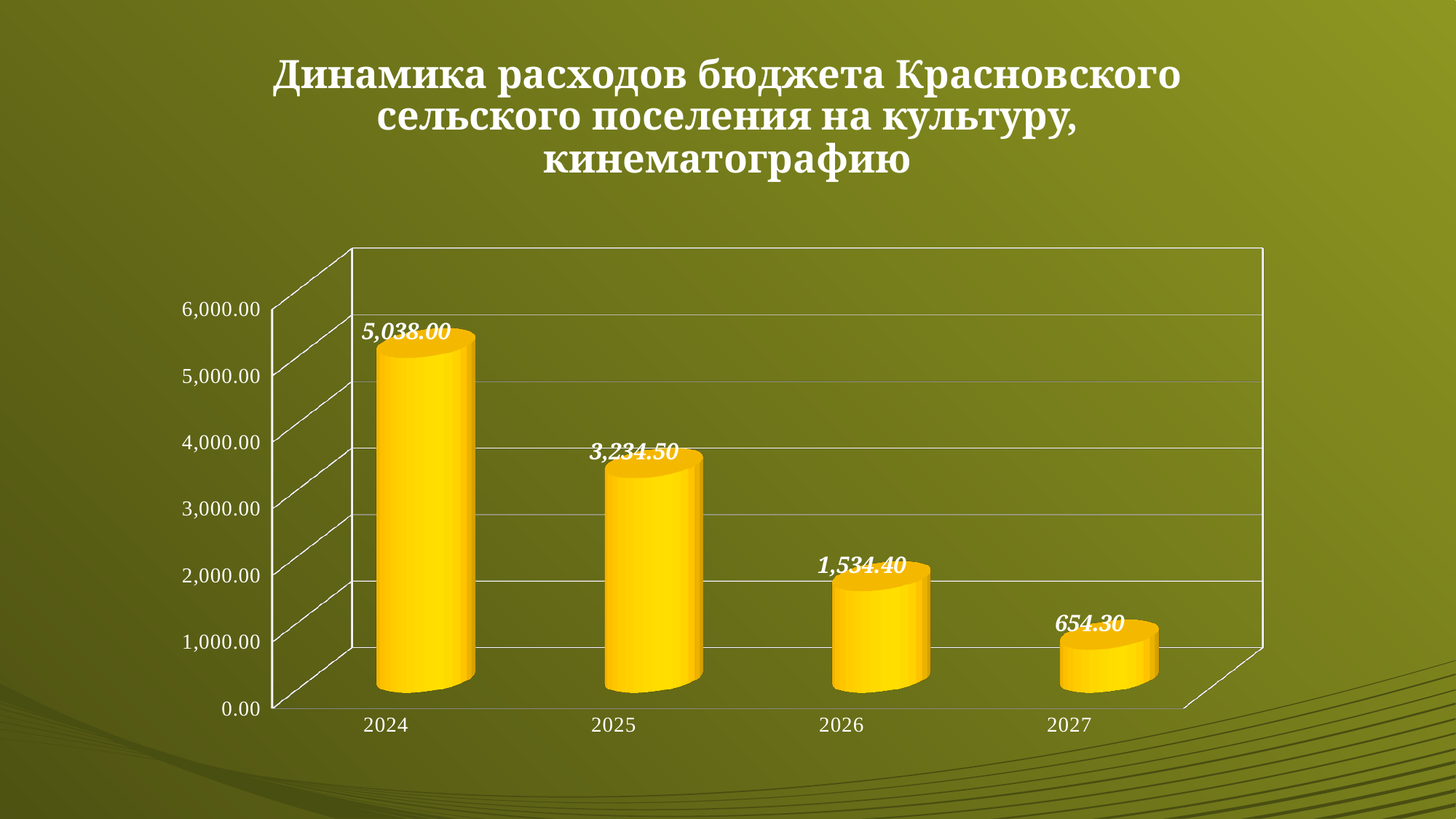
What is the value for 2025? 3,234.50 What is the value for 2024? 5,038.00 How many years are shown on the x axis? 4 Which year has the lowest value? 2027 What is the value for 2027? 654.30 What is the difference between the values for 2026 and 2027? 880.10 Which year has the highest value? 2024 What is the difference between the values for 2024 and 2025? 1,803.50 What kind of chart is shown on the slide? bar chart What is the value for 2026? 1,534.40 Do the values rise or fall from 2024 to 2027? fall Which is larger, the value for 2025 or the value for 2026? 2025